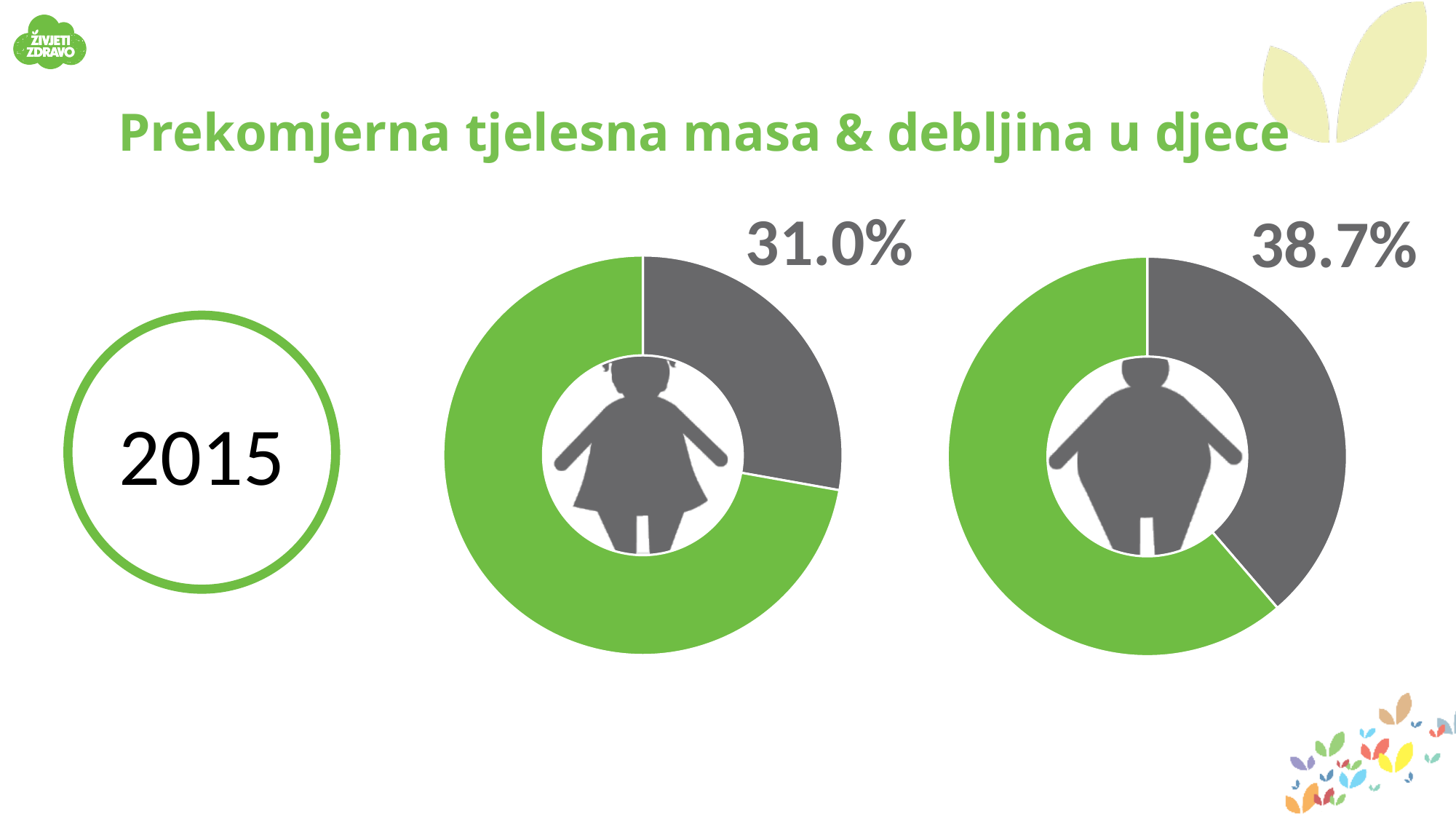
What kind of charts are shown on the slide? donut (pie) charts What is the difference between the percentage on the right donut chart and the percentage on the left donut chart? 7.7 percentage points What percentage is shown above the right donut chart (with the boy icon)? 38.7% What percentage is shown above the left donut chart (with the girl icon)? 31.0% In the left donut chart, is the grey segment greater or less than 50% of the ring? less How many donut charts are on the slide? 2 What year is shown in the circle on the left of the slide? 2015 In the right donut chart, what share of the ring is the grey segment? 38.7% Which colour is used for the larger segment in both donut charts? green Which donut chart shows the higher percentage, the left one (girl) or the right one (boy)? the right one (boy)